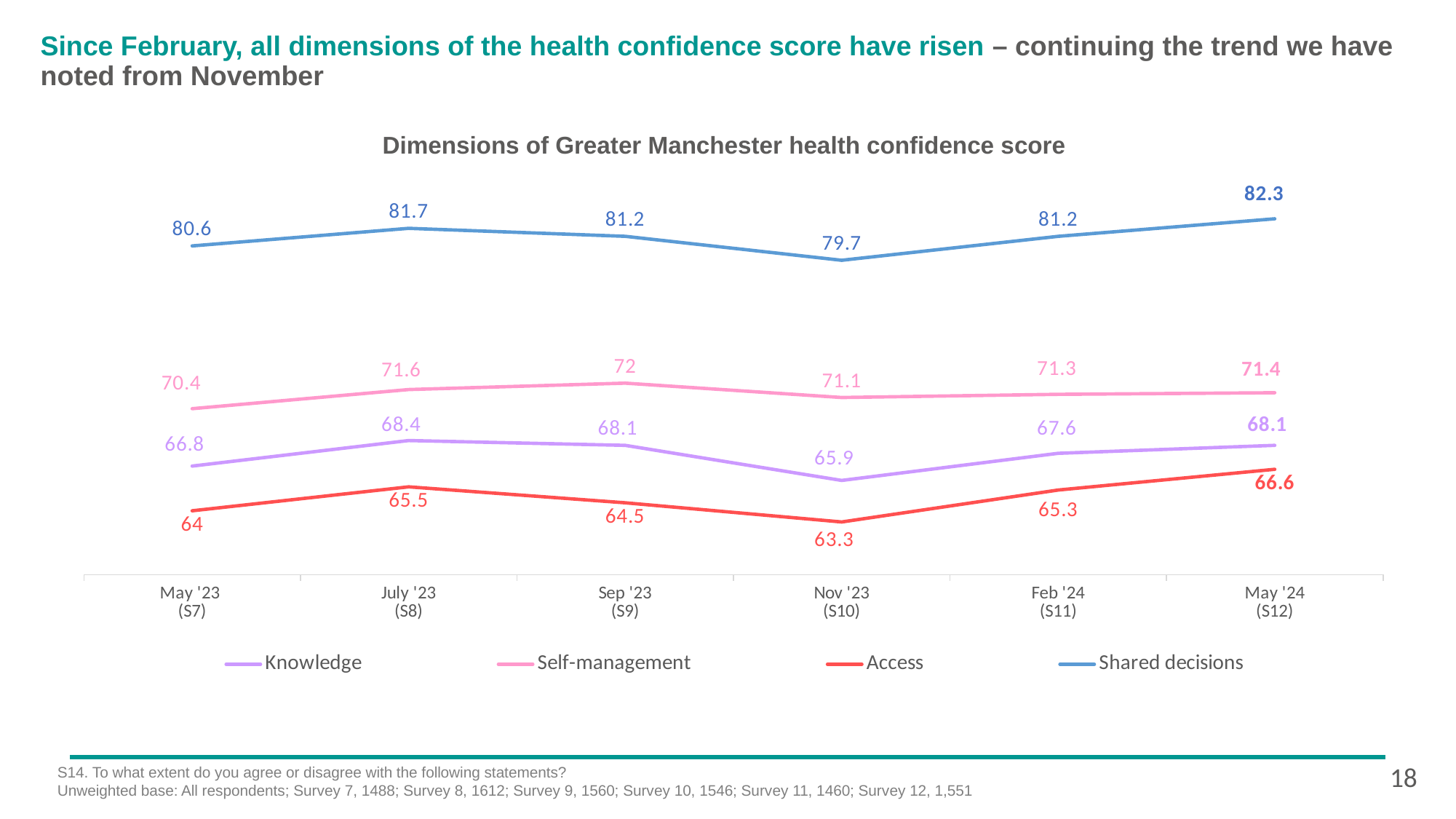
How many series does the legend list? 4 What is the Access score in Nov '23 (S10)? 63.3 What is the difference between the Access score in May '24 and in Feb '24? 1.3 What is the Knowledge score in Feb '24 (S11)? 67.6 How many survey periods are shown on the x axis? 6 What is the title of the chart? Dimensions of Greater Manchester health confidence score In which survey period is the Access score lowest? Nov '23 (S10) In which survey period is the Shared decisions score highest? May '24 (S12) What is the Self-management score in Sep '23 (S9)? 72 Which is higher in May '23: the Knowledge score or the Self-management score? Self-management What is the Shared decisions score in May '24 (S12)? 82.3 What kind of chart is shown on the slide? Line chart